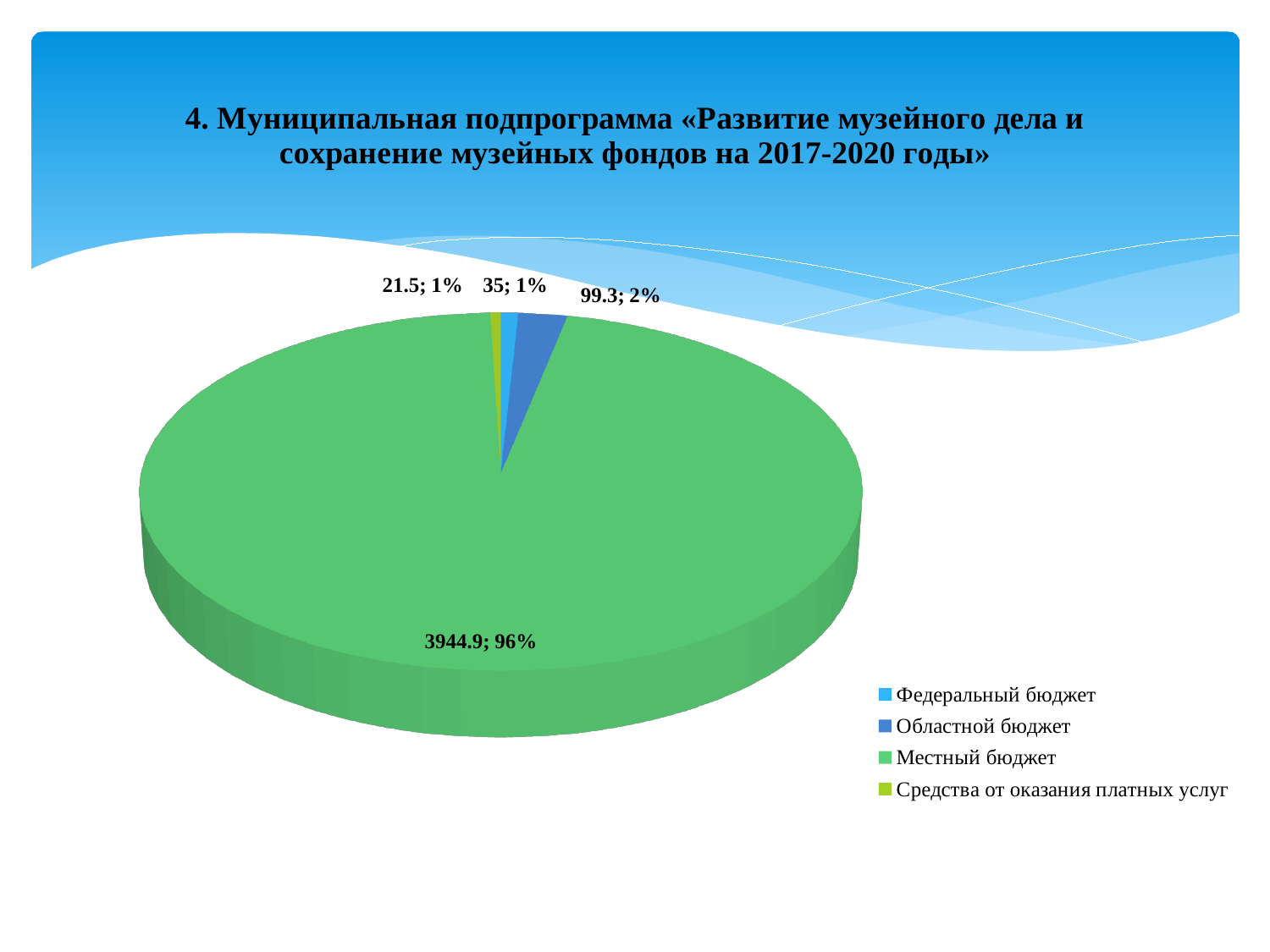
How many slices does the pie chart have? 4 What share of the pie does Местный бюджет represent? 96% What type of chart is shown on the slide? Pie chart How many entries does the legend list? 4 Which category has the largest slice? Местный бюджет What is the difference between the values for Областной бюджет and Федеральный бюджет? 64.3 What is the value for Областной бюджет? 99.3 What is the value for Федеральный бюджет? 35 Which category has the smallest slice? Средства от оказания платных услуг What is the value for Средства от оказания платных услуг? 21.5 What share of the pie does Областной бюджет represent? 2% What is the value for Местный бюджет? 3944.9